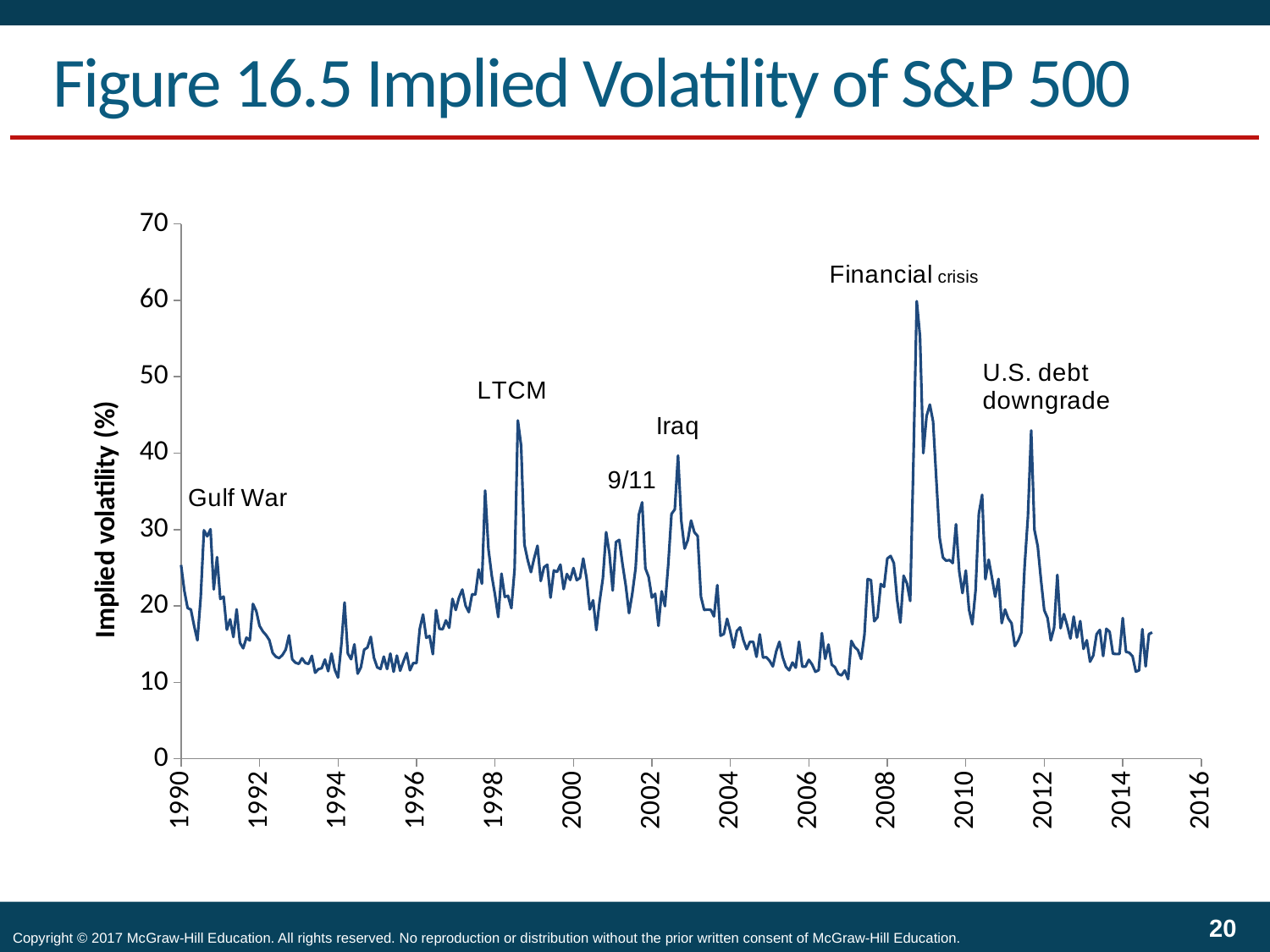
What kind of chart is shown on the slide? line chart Which annotated event corresponds to the highest peak in implied volatility? Financial crisis Is the peak implied volatility labeled Gulf War greater or less than 40? less What is the title of the chart? Figure 16.5 Implied Volatility of S&P 500 Which peak is higher, the Financial crisis or the U.S. debt downgrade? Financial crisis Is the peak implied volatility labeled 9/11 greater or less than 40? less Between 2003 and 2006, does implied volatility generally rise or fall? fall Is the peak implied volatility labeled LTCM greater or less than 40? greater How many events are annotated on the chart? 6 What is the label on the y-axis of the chart? Implied volatility (%)